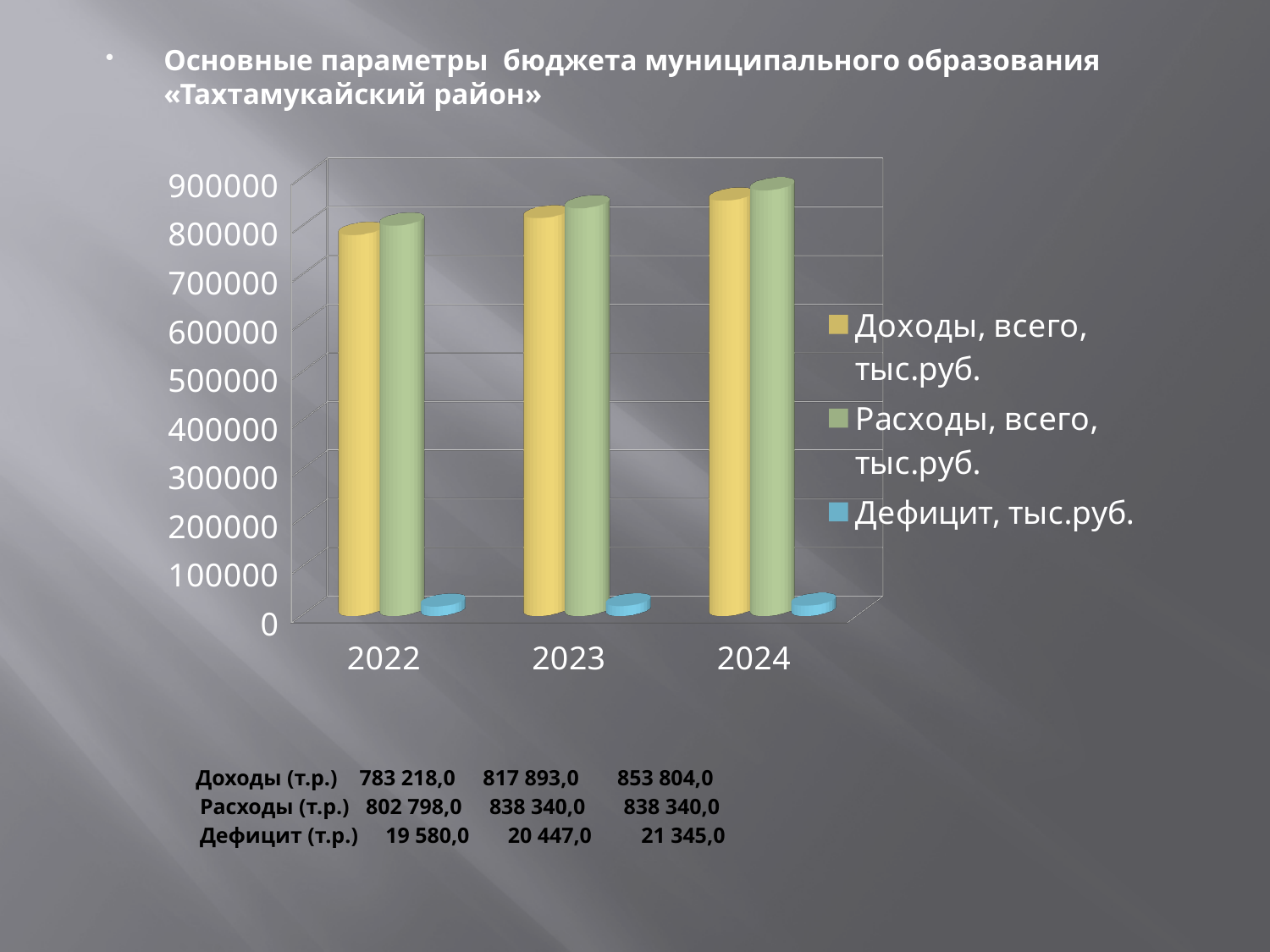
In which year is Доходы, всего the highest? 2024 Do the values for Доходы, всего rise or fall from 2022 to 2024? rise How many years are shown on the x axis of the chart? 3 What is the value of Доходы (т.р.) for 2024? 853 804,0 What is the value of Дефицит (т.р.) for 2022? 19 580,0 What is the value of Дефицит (т.р.) for 2024? 21 345,0 For 2022, which is larger: Доходы, всего or Расходы, всего? Расходы, всего By how much did Доходы (т.р.) increase from 2022 to 2023? 34 675,0 How many series does the chart legend list? 3 What is the value of Расходы (т.р.) for 2023? 838 340,0 What kind of chart is shown on the slide? bar chart What is the value of Доходы (т.р.) for 2022? 783 218,0